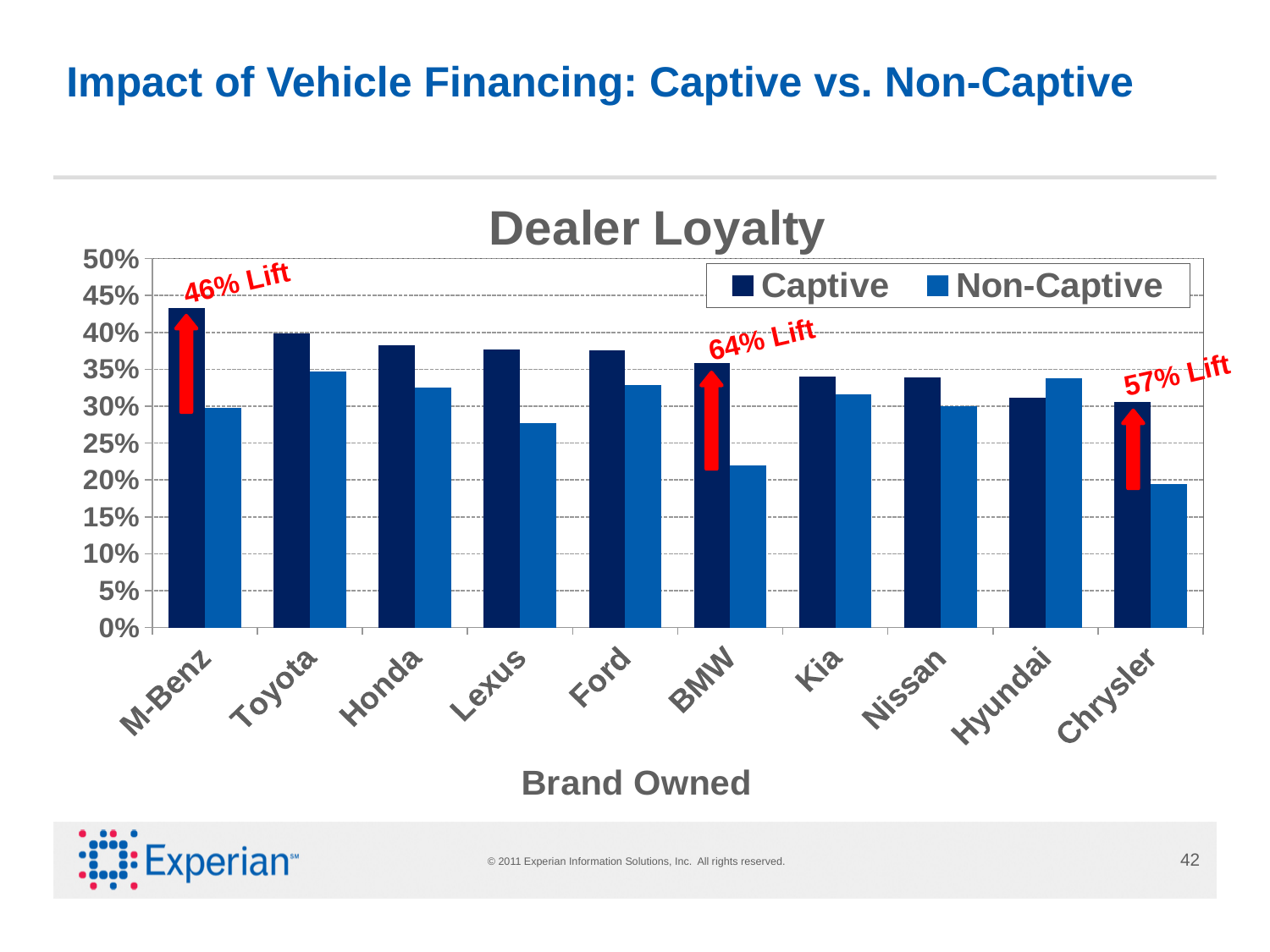
Do the Captive values generally rise or fall moving from M-Benz to Chrysler along the x axis? fall Which brand has the highest Captive dealer loyalty value? M-Benz Is the Captive value for M-Benz greater or less than 40%? greater Is the Non-Captive value for BMW greater or less than 25%? less How many brands are shown on the x axis of the Dealer Loyalty chart? 10 How many series does the legend of the Dealer Loyalty chart list? 2 For Hyundai, which is larger: the Captive or the Non-Captive value? Non-Captive Is the Non-Captive value for Lexus greater or less than 30%? less What lift is annotated above the BMW bars? 64% Lift Which brand has the lowest Non-Captive dealer loyalty value? Chrysler What kind of chart is shown on the slide? bar chart Which is larger: the Captive value for Toyota or the Captive value for Chrysler? Toyota